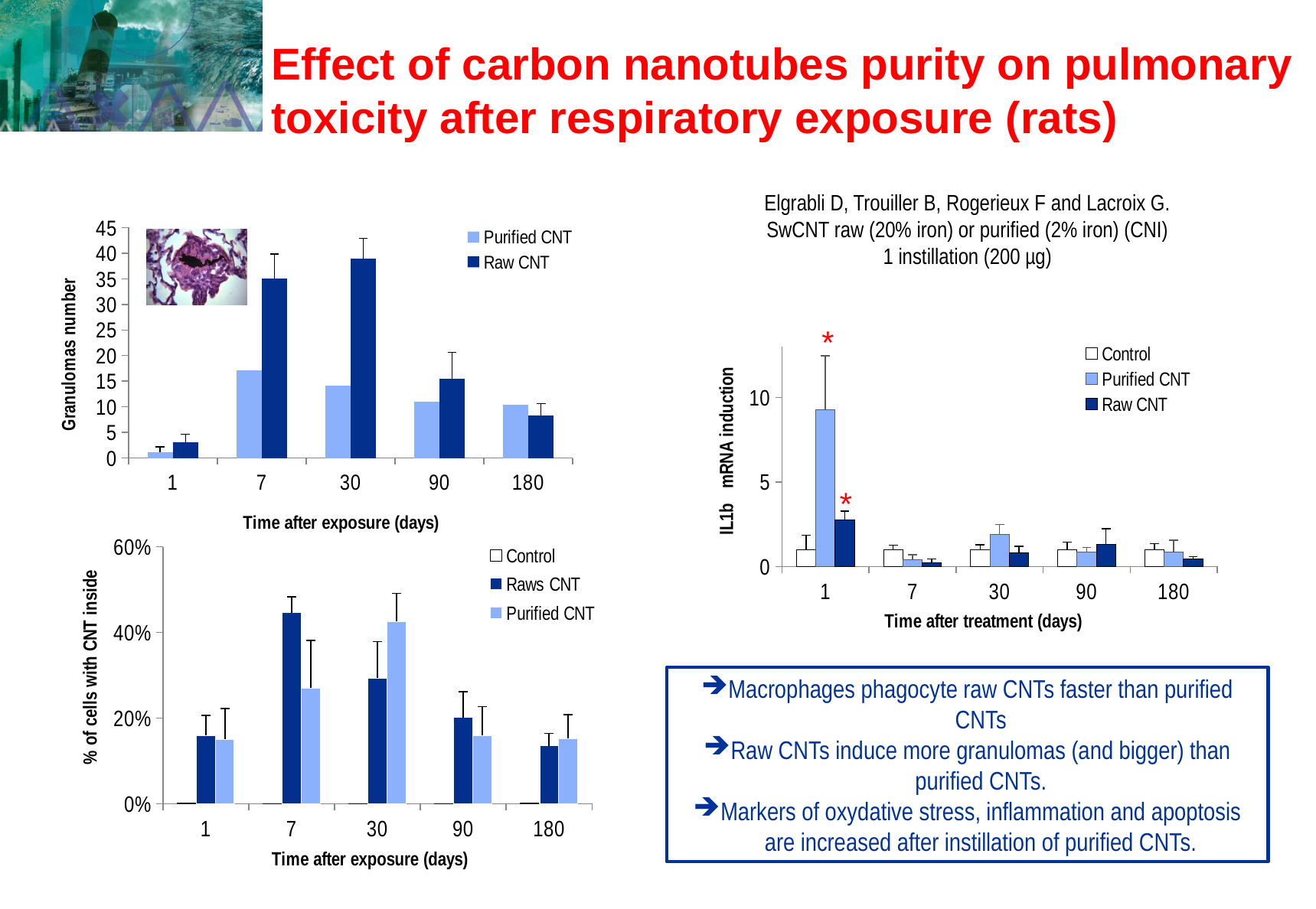
What kind of chart is the right chart (IL1b mRNA induction)? bar chart In the right chart (IL1b mRNA induction), which is larger at 1 day: Purified CNT or Raw CNT? Purified CNT How many series does the legend of the bottom-left chart (% of cells with CNT inside) list? 3 In the top-left chart (Granulomas number), is the Purified CNT value at 30 days greater or less than 20? less How many time points are shown on the x axis of the top-left chart (Granulomas number)? 5 In the top-left chart (Granulomas number), which is larger at 7 days: Purified CNT or Raw CNT? Raw CNT In the bottom-left chart (% of cells with CNT inside), is the Purified CNT value at 7 days greater or less than 40%? less In the bottom-left chart (% of cells with CNT inside), which series and time point has the highest value? Raws CNT at 7 days In the top-left chart (Granulomas number), which series and time point has the highest value? Raw CNT at 30 days In the bottom-left chart (% of cells with CNT inside), which is larger at 30 days: Raws CNT or Purified CNT? Purified CNT In the top-left chart (Granulomas number), is the Raw CNT value at 30 days greater or less than 35? greater